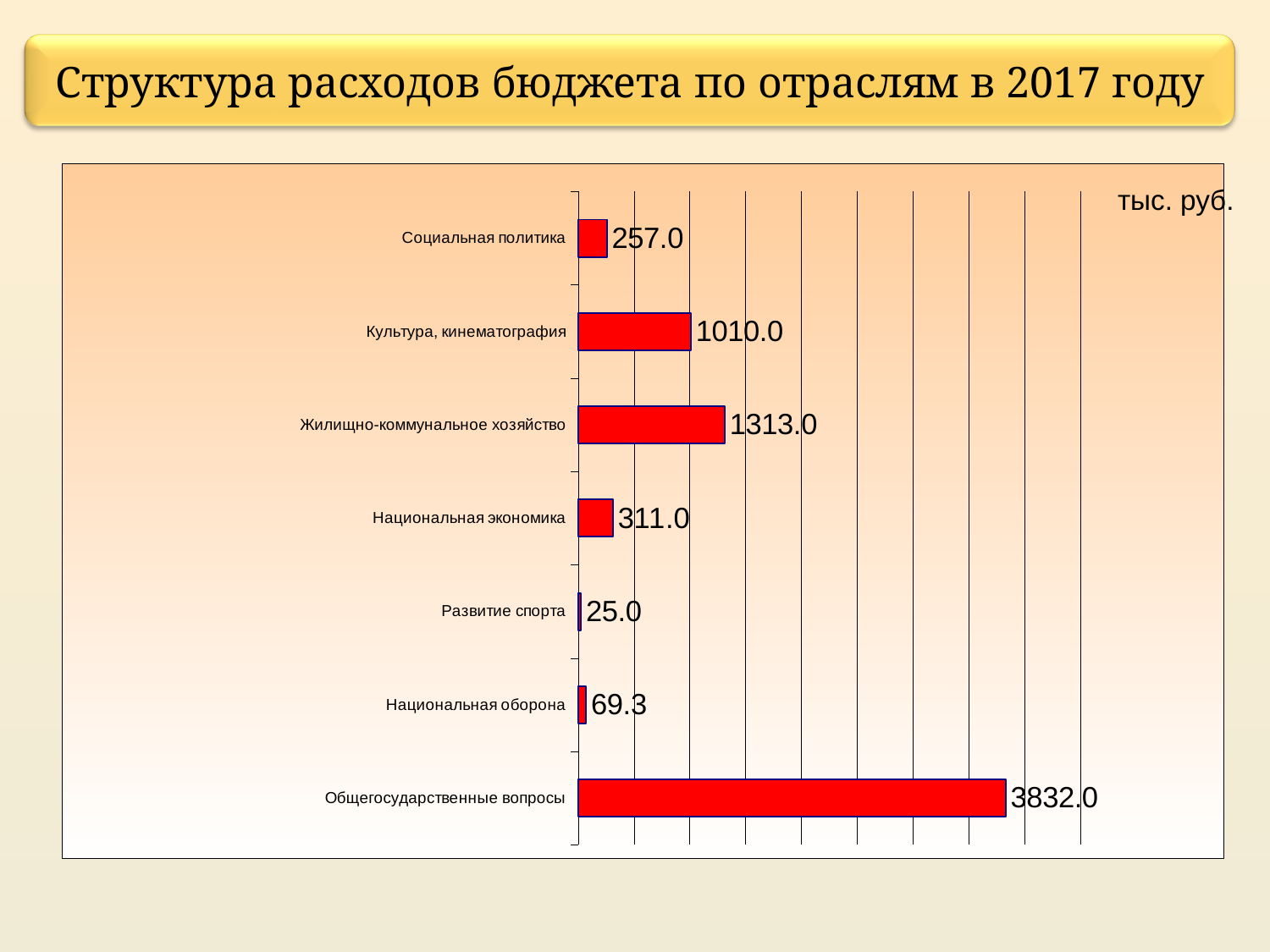
Which category has the lowest value? Развитие спорта Which category has the highest value? Общегосударственные вопросы How many categories are shown in the chart? 7 What is the value for Жилищно-коммунальное хозяйство? 1313.0 What is the value for Развитие спорта? 25.0 What is the value for Социальная политика? 257.0 What is the difference between the values for Жилищно-коммунальное хозяйство and Культура, кинематография? 303.0 What unit is indicated in the top right corner of the chart? тыс. руб. What kind of chart is shown on the slide? Bar chart What is the difference between the values for Общегосударственные вопросы and Жилищно-коммунальное хозяйство? 2519.0 What is the value for Национальная оборона? 69.3 Which is larger, the value for Национальная экономика or the value for Социальная политика? Национальная экономика